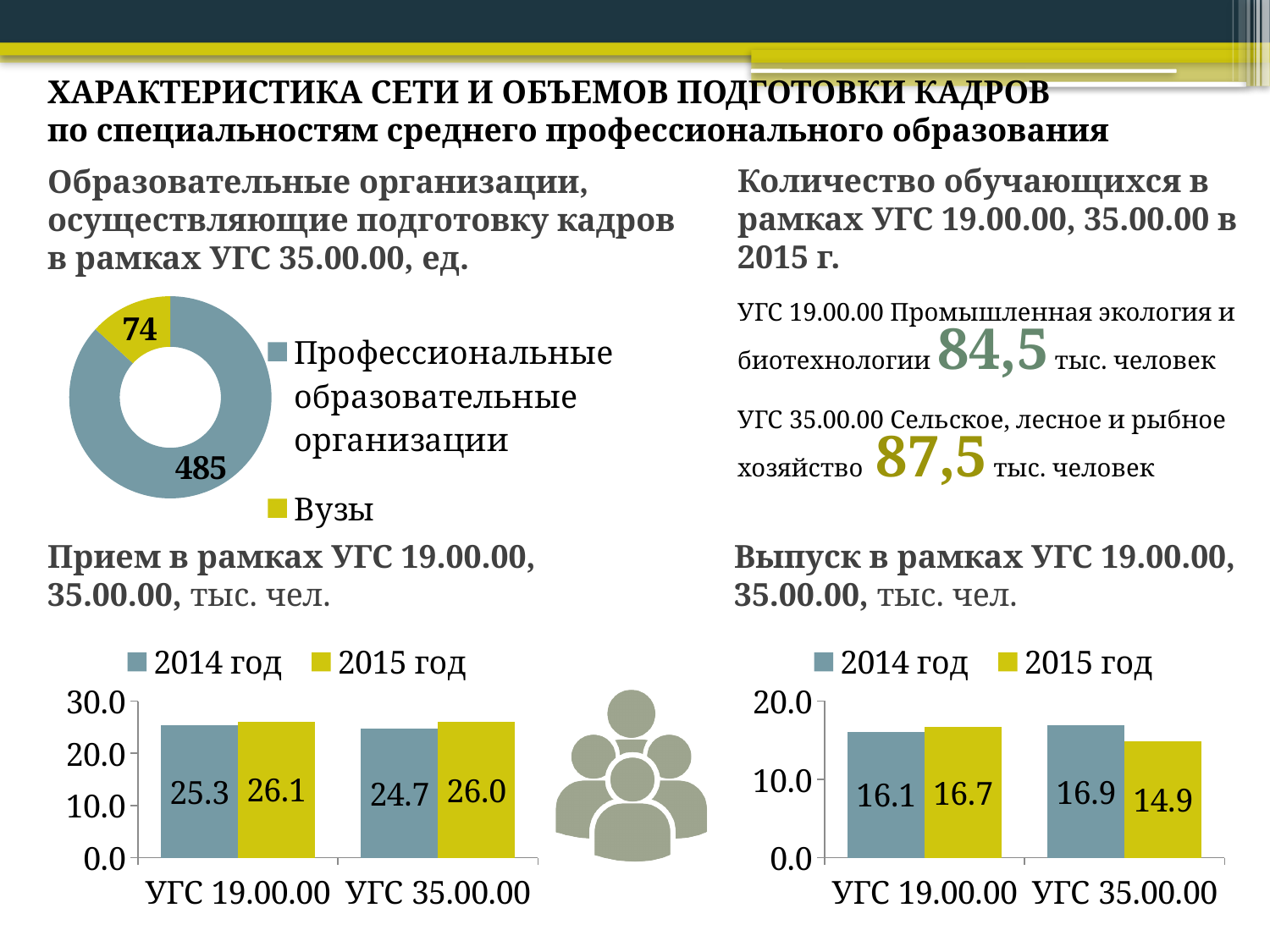
In the donut chart on the top left, what is the value for Вузы? 74 In the chart 'Выпуск в рамках УГС 19.00.00, 35.00.00', which is larger for УГС 19.00.00: 2014 год or 2015 год? 2015 год In the chart 'Прием в рамках УГС 19.00.00, 35.00.00', what is the difference between the 2015 год and 2014 год values for УГС 35.00.00? 1.3 In the chart 'Выпуск в рамках УГС 19.00.00, 35.00.00', which bar is the lowest? УГС 35.00.00, 2015 год In the chart 'Прием в рамках УГС 19.00.00, 35.00.00', how many series does the legend list? 2 In the chart 'Выпуск в рамках УГС 19.00.00, 35.00.00', what is the value for УГС 35.00.00 in 2015 год? 14.9 In the donut chart on the top left, what is the total of the two segments? 559 In the chart 'Прием в рамках УГС 19.00.00, 35.00.00', what is the value for УГС 19.00.00 in 2014 год? 25.3 In the chart 'Выпуск в рамках УГС 19.00.00, 35.00.00', what is the difference between the 2014 год and 2015 год values for УГС 35.00.00? 2.0 In the donut chart on the top left, what is the value for Профессиональные образовательные организации? 485 In the chart 'Прием в рамках УГС 19.00.00, 35.00.00', what is the value for УГС 35.00.00 in 2015 год? 26.0 What kind of chart is shown on the top left of the slide? Donut (pie) chart